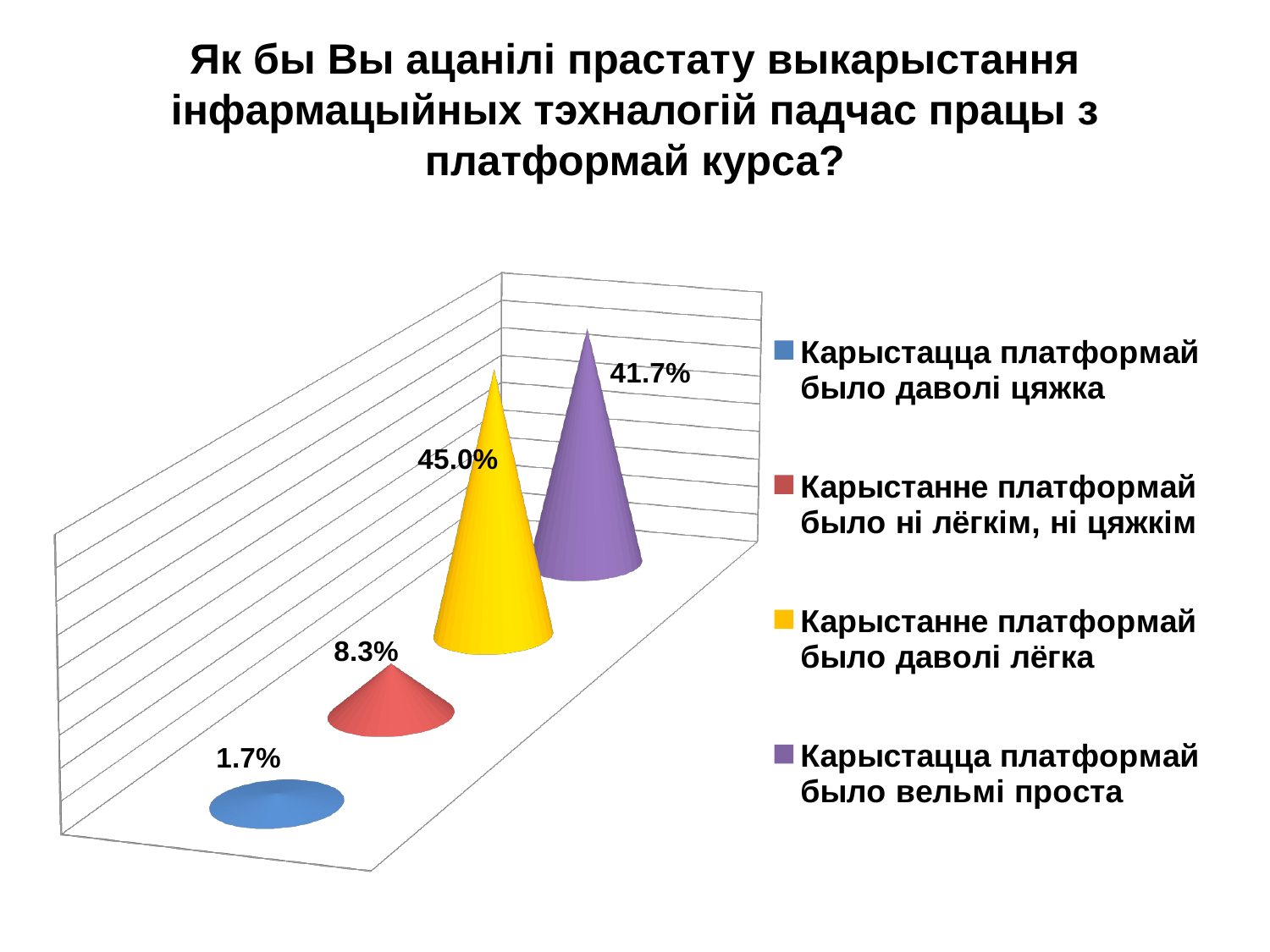
What kind of chart is shown on the slide? bar chart What is the value for "Карыстанне платформай было ні лёгкім, ні цяжкім"? 8.3% Which is larger: the value for "Карыстанне платформай было ні лёгкім, ні цяжкім" or for "Карыстацца платформай было даволі цяжка"? Карыстанне платформай было ні лёгкім, ні цяжкім What is the value for "Карыстанне платформай было даволі лёгка"? 45.0% What is the value for "Карыстацца платформай было даволі цяжка"? 1.7% What colour is the bar for "Карыстанне платформай было даволі лёгка"? yellow How many bars are plotted on the chart? 4 Which response has the highest value? Карыстанне платформай было даволі лёгка Which response has the lowest value? Карыстацца платформай было даволі цяжка How many series does the legend list? 4 What is the value for "Карыстацца платформай было вельмі проста"? 41.7% What is the difference between the values for "Карыстанне платформай было даволі лёгка" and "Карыстацца платформай было вельмі проста"? 3.3%